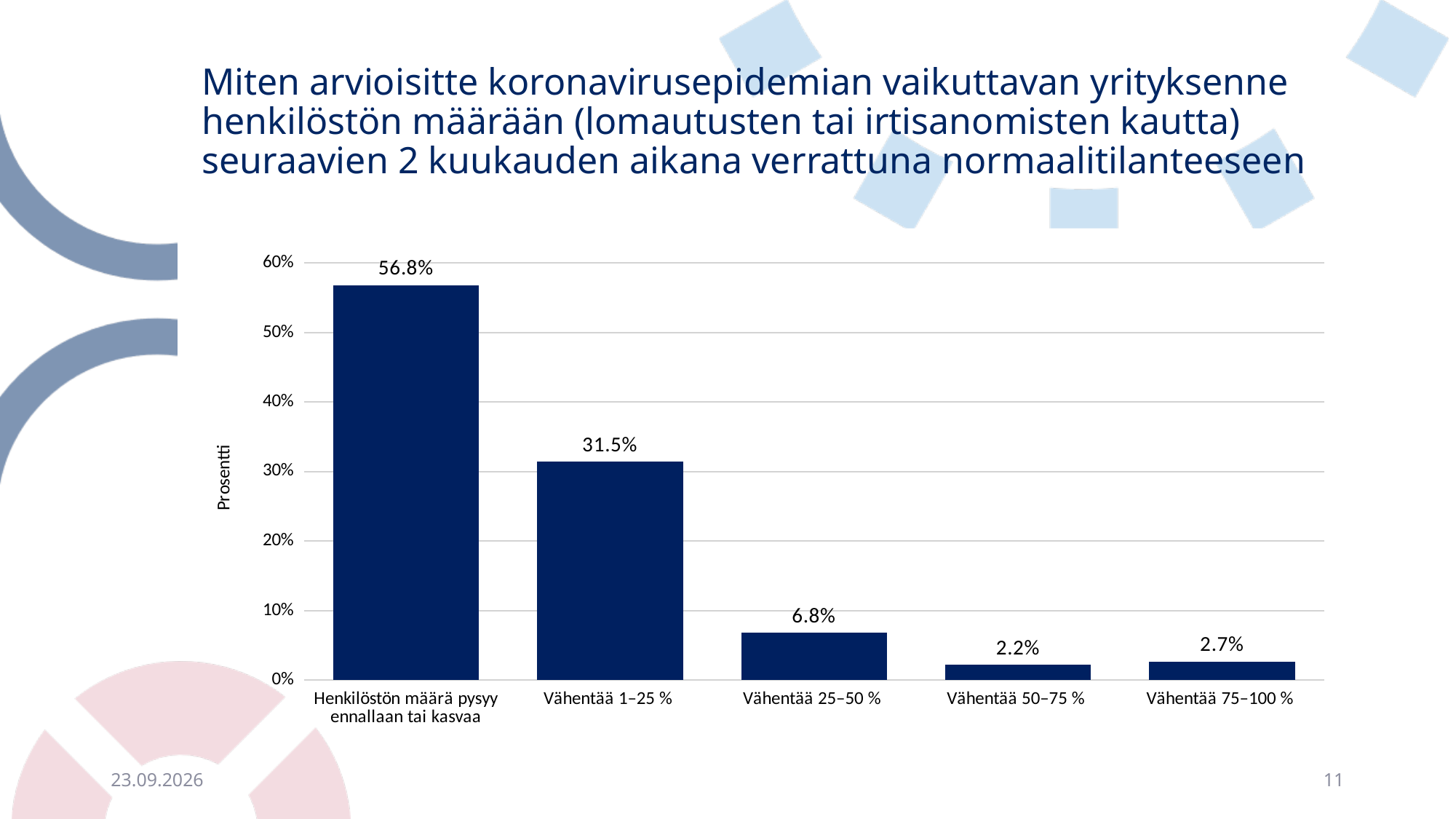
Is the value for "Vähentää 1–25 %" greater or less than 40%? less What is the value for "Vähentää 25–50 %"? 6.8% Which category has the highest value? Henkilöstön määrä pysyy ennallaan tai kasvaa What is the difference between the values for "Henkilöstön määrä pysyy ennallaan tai kasvaa" and "Vähentää 1–25 %"? 25.3% What is the value for "Vähentää 50–75 %"? 2.2% Which is larger, the value for "Vähentää 25–50 %" or "Vähentää 75–100 %"? Vähentää 25–50 % What kind of chart is shown on the slide? bar chart What is the value for "Henkilöstön määrä pysyy ennallaan tai kasvaa"? 56.8% Which category has the lowest value? Vähentää 50–75 % What is the value for "Vähentää 75–100 %"? 2.7% How many categories are shown on the x axis? 5 What is the value for "Vähentää 1–25 %"? 31.5%